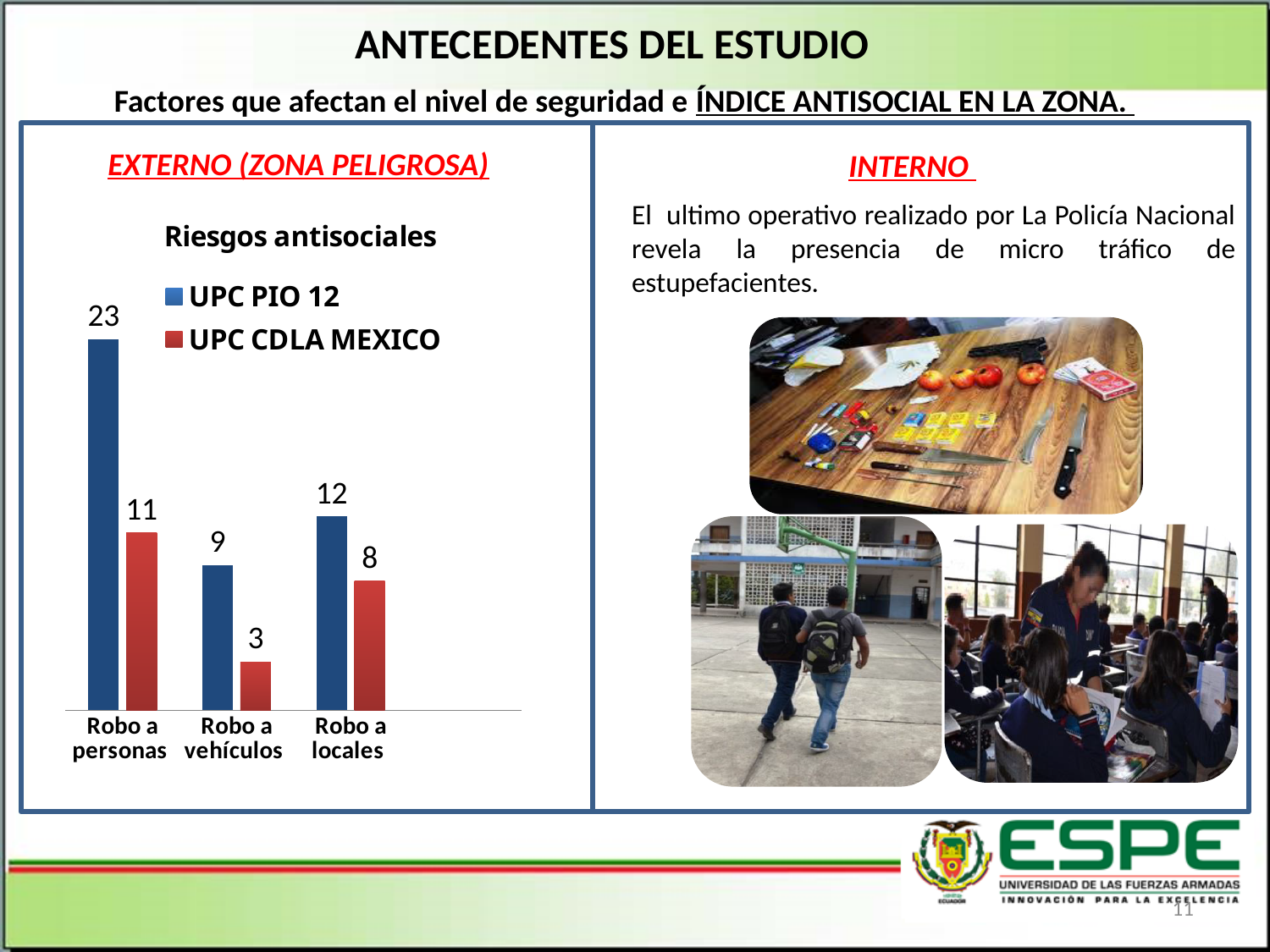
What is the value for UPC CDLA MEXICO in the Robo a vehículos category? 3 How many categories are shown on the x axis of the chart? 3 How many series does the chart legend list? 2 Which category has the highest value for UPC PIO 12? Robo a personas What kind of chart is shown on the slide? Bar chart What is the value for UPC CDLA MEXICO in the Robo a locales category? 8 Which is larger in the Robo a locales category, UPC PIO 12 or UPC CDLA MEXICO? UPC PIO 12 Which category has the lowest value for UPC CDLA MEXICO? Robo a vehículos What is the difference between UPC PIO 12 and UPC CDLA MEXICO in the Robo a personas category? 12 What is the title of the chart? Riesgos antisociales Which series is shown in red in the chart? UPC CDLA MEXICO What is the value for UPC PIO 12 in the Robo a personas category? 23